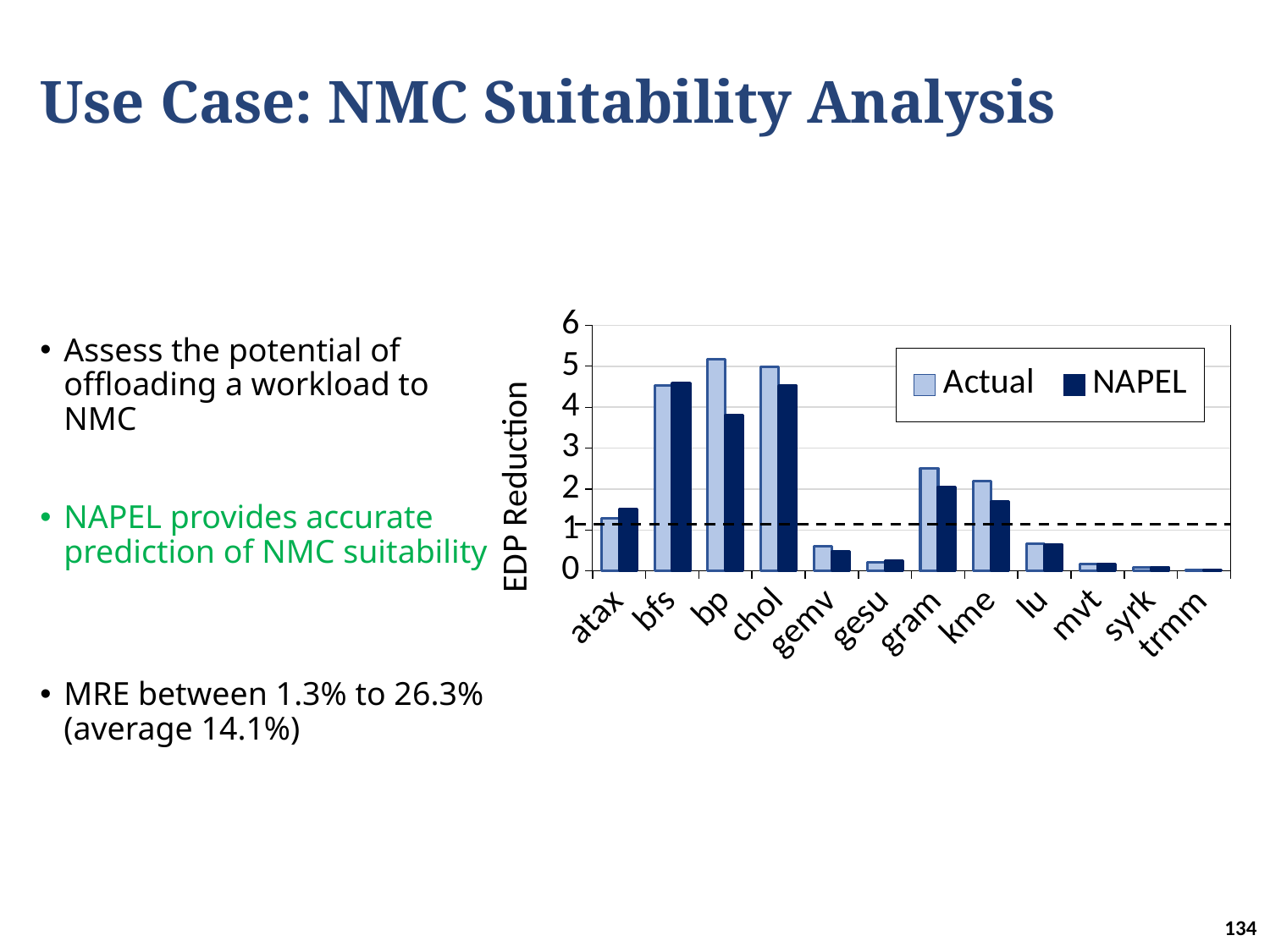
For bp, which series has the larger EDP Reduction, Actual or NAPEL? Actual Is the Actual EDP Reduction for gram greater or less than 2? greater Which workload has the lowest EDP Reduction for the Actual series? trmm Is the NAPEL EDP Reduction for bp greater or less than 4? less For atax, which series has the larger EDP Reduction, Actual or NAPEL? NAPEL What are the two series named in the chart's legend? Actual and NAPEL What is the label on the y axis of the chart? EDP Reduction Is the Actual EDP Reduction for bfs greater or less than 4? greater What kind of chart is shown on the slide? bar chart How many workload categories are shown on the x axis of the chart? 12 How many series does the chart's legend list? 2